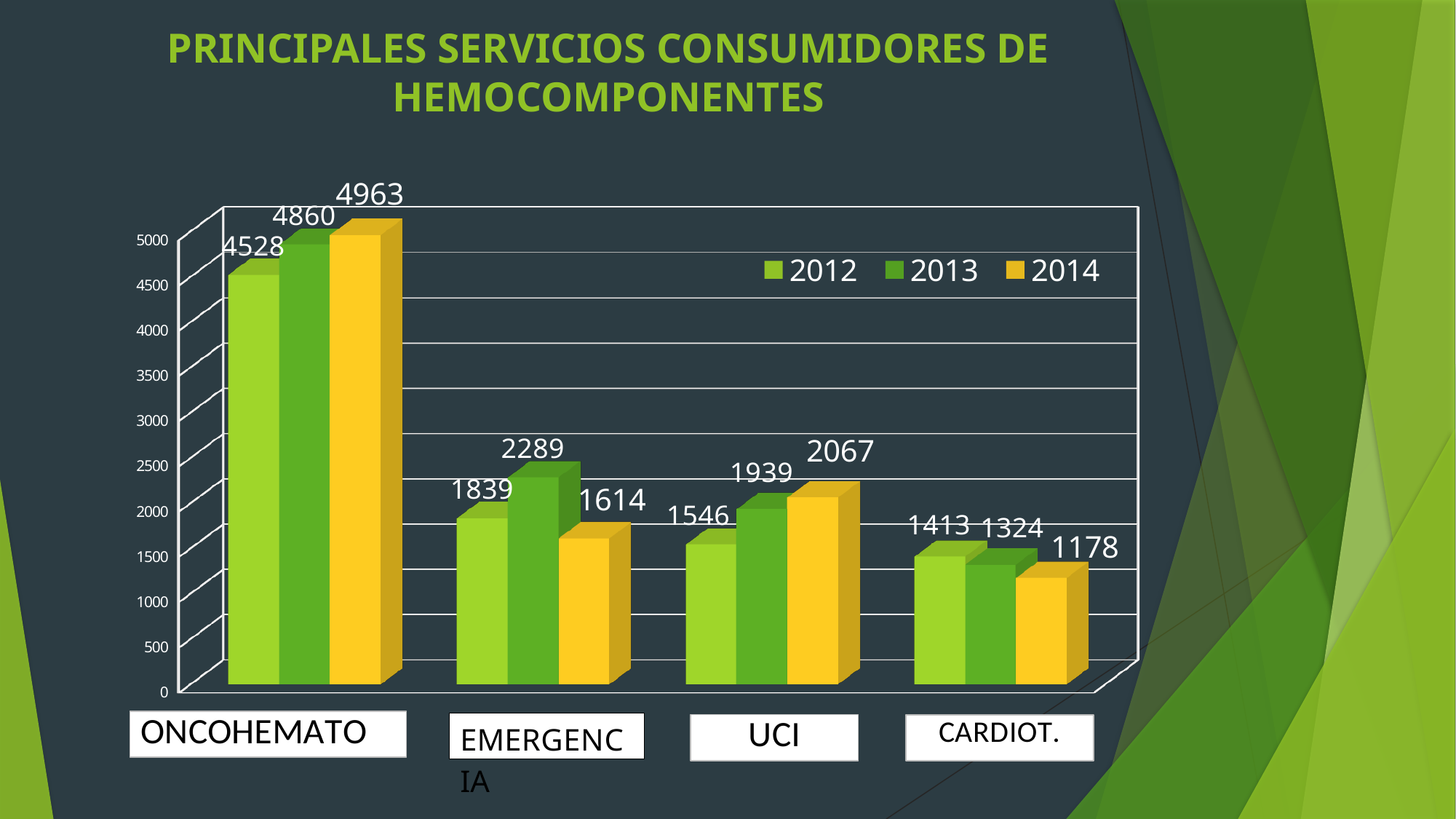
What is the value for UCI in 2012? 1546 What is the difference between the 2014 and 2012 values for ONCOHEMATO? 435 Which category has the highest value in 2013? ONCOHEMATO Which is larger for EMERGENCIA: the 2012 value or the 2014 value? 2012 Do the values for UCI rise or fall from 2012 to 2014? Rise How many categories are shown on the x axis? 4 What is the value for EMERGENCIA in 2013? 2289 Which category has the lowest value in 2014? CARDIOT. How many series does the legend list? 3 What kind of chart is shown on the slide? Bar chart What is the value for ONCOHEMATO in 2014? 4963 What is the value for CARDIOT. in 2014? 1178